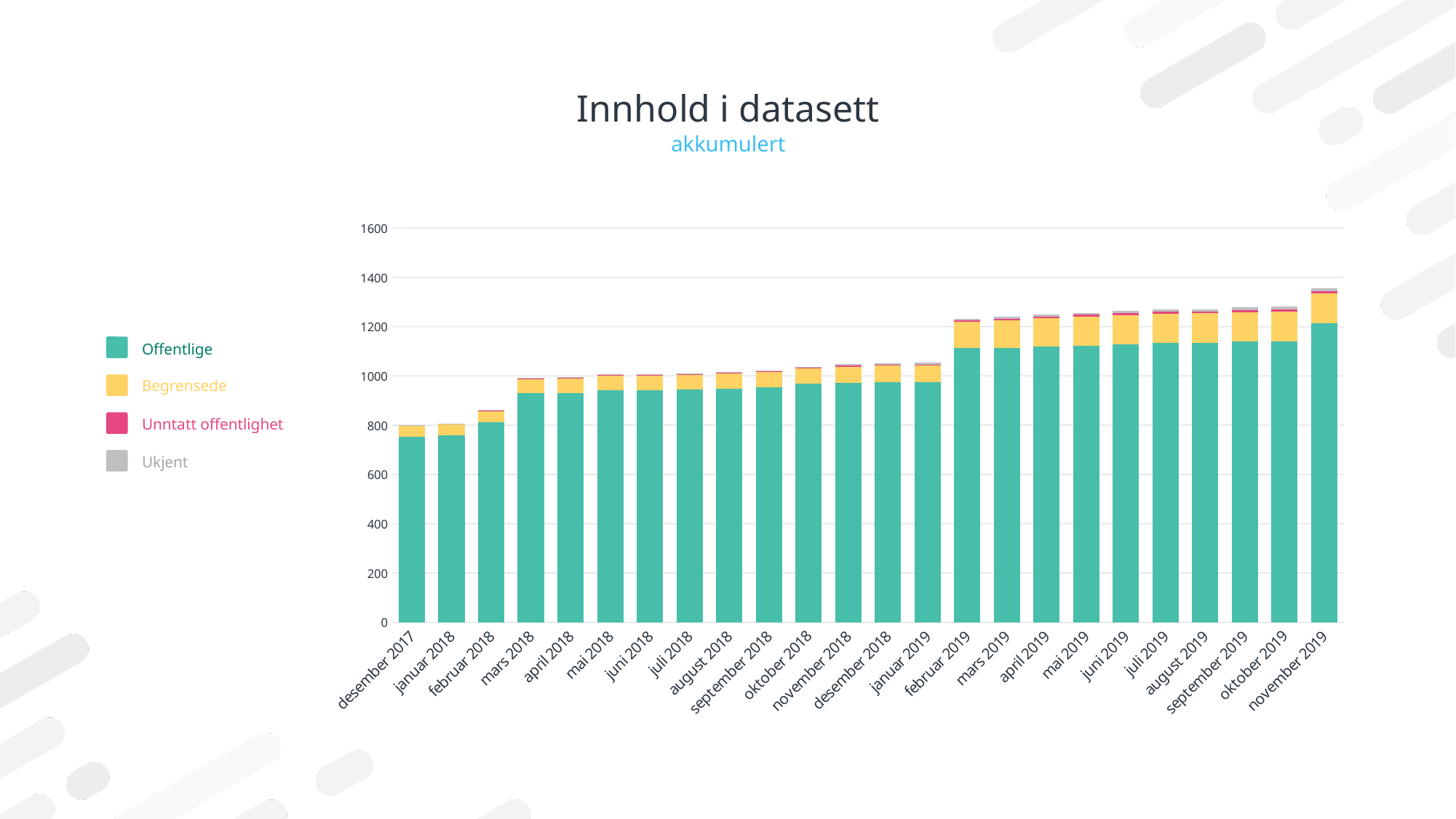
Which series is shown in yellow in the legend? Begrensede How many months (categories) are shown on the x axis? 24 Do the total bar heights generally rise or fall from desember 2017 to november 2019? rise How many series does the legend list? 4 Which month has the highest total bar? november 2019 Is the total bar for desember 2017 greater or less than 1000? less What is the title of the chart? Innhold i datasett Which month has the lowest total bar? desember 2017 Is the total bar for februar 2019 greater or less than 1200? greater Which is larger, the total bar for februar 2018 or the total bar for mars 2018? mars 2018 What kind of chart is shown on the slide? stacked bar chart